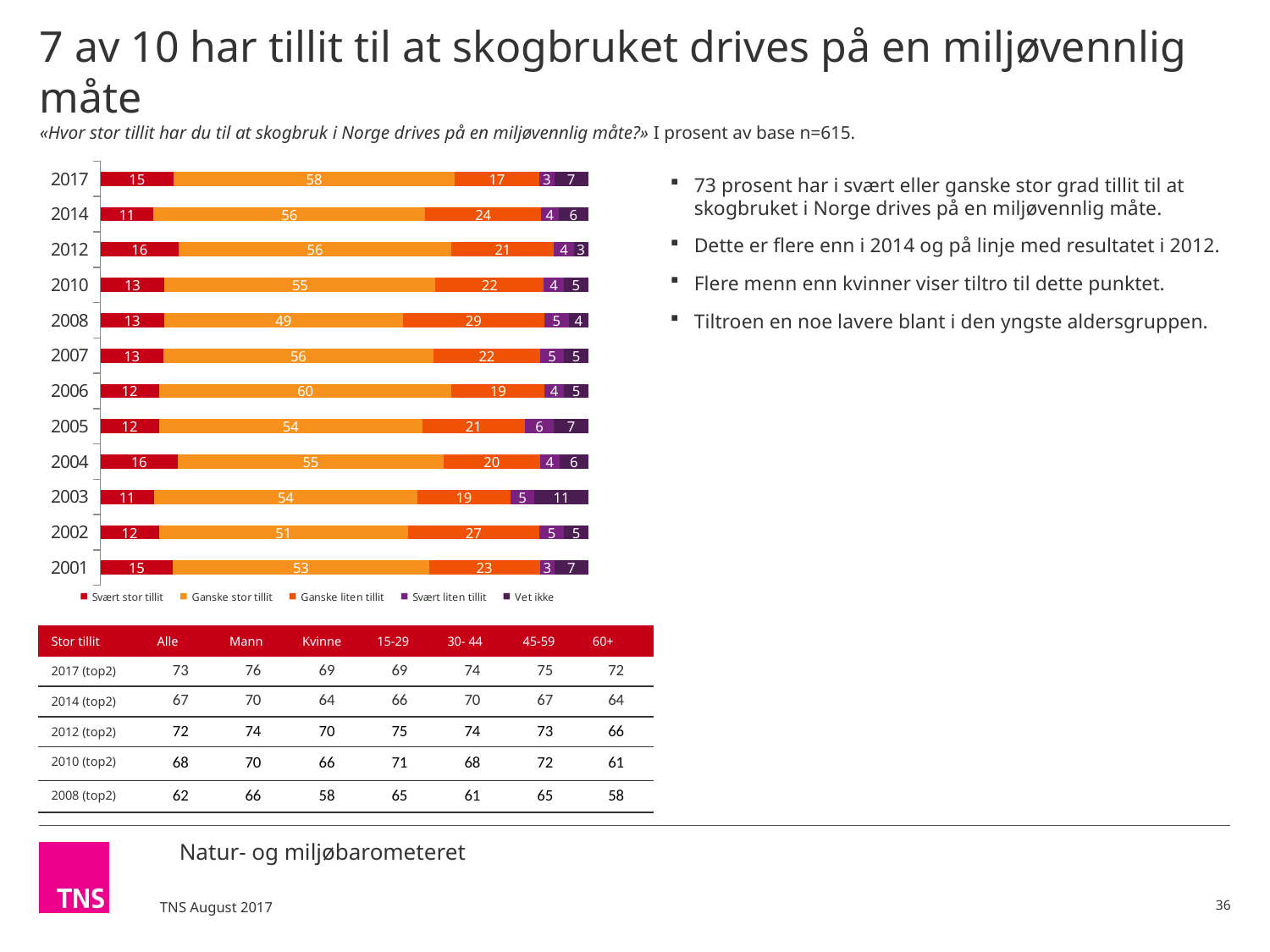
What is the value of 'Ganske liten tillit' for 2008? 29 What is the total of the stacked bar for 2017? 100 What is the value of 'Vet ikke' for 2003? 11 Which year has a larger 'Svært stor tillit' value, 2012 or 2014? 2012 How many series does the chart legend list? 5 What kind of chart is shown on the slide? stacked bar chart What is the value of 'Ganske stor tillit' for 2017? 58 In which year is the 'Ganske stor tillit' value highest? 2006 Which legend entry is shown in the first (leftmost) position? Svært stor tillit What is the difference between the 'Ganske liten tillit' values for 2014 and 2017? 7 How many years (categories) are plotted in the chart? 12 In which year is the 'Ganske liten tillit' value lowest? 2017